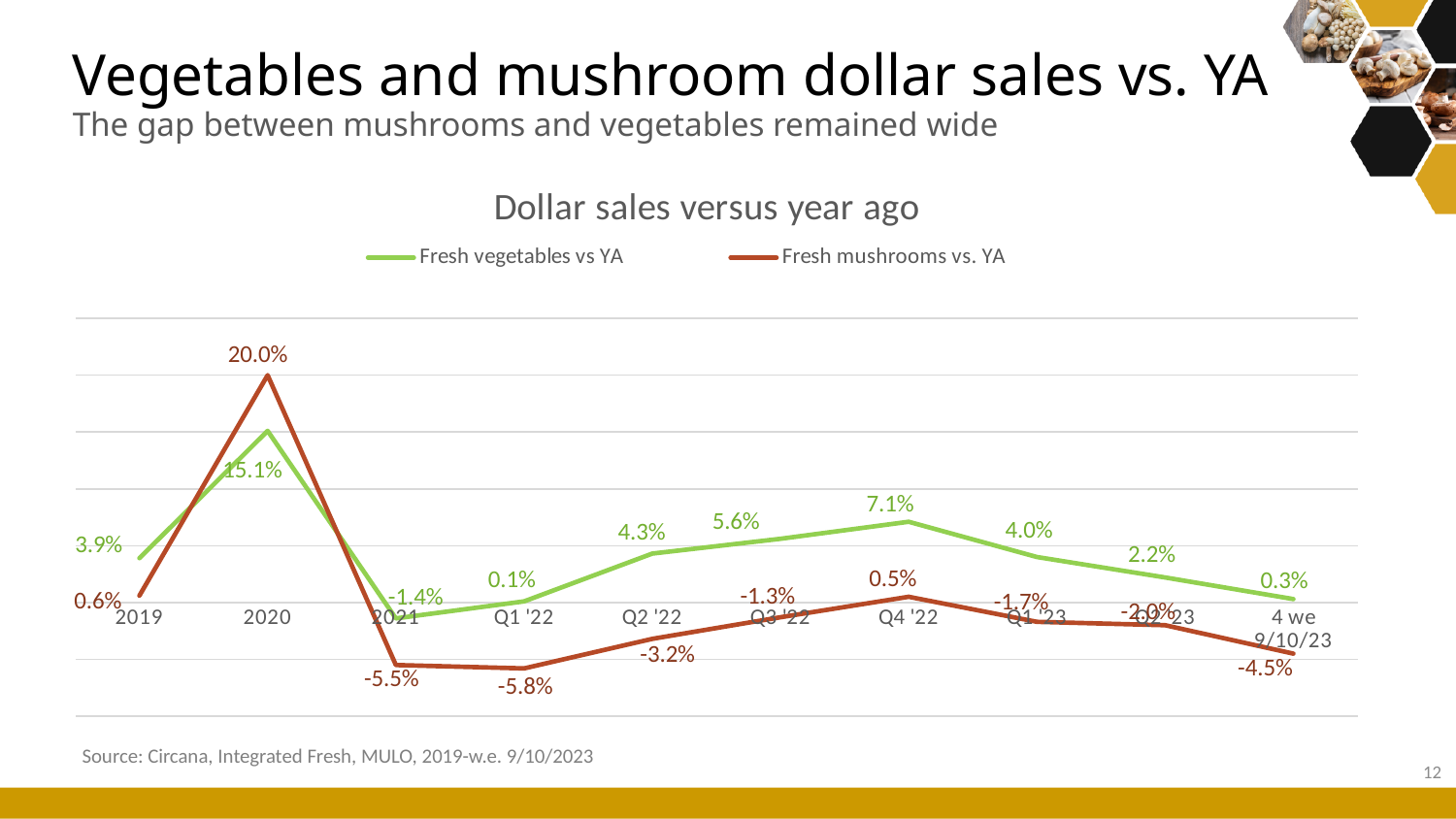
What is the value for Fresh mushrooms vs. YA for the 4 we 9/10/23 period? -4.5% What is the value for Fresh mushrooms vs. YA in Q1 '22? -5.8% In which period is Fresh mushrooms vs. YA at its lowest? Q1 '22 How many time periods are shown on the x axis? 10 What is the value for Fresh mushrooms vs. YA in 2020? 20.0% In 2020, how much higher is Fresh mushrooms vs. YA than Fresh vegetables vs YA? 4.9 percentage points In Q4 '22, which series has the higher value, Fresh vegetables vs YA or Fresh mushrooms vs. YA? Fresh vegetables vs YA In which period is Fresh mushrooms vs. YA at its highest? 2020 What is the value for Fresh vegetables vs YA in Q4 '22? 7.1% What type of chart is shown on the slide? Line chart What is the value for Fresh vegetables vs YA in 2020? 15.1% In which period is Fresh vegetables vs YA at its lowest? 2021